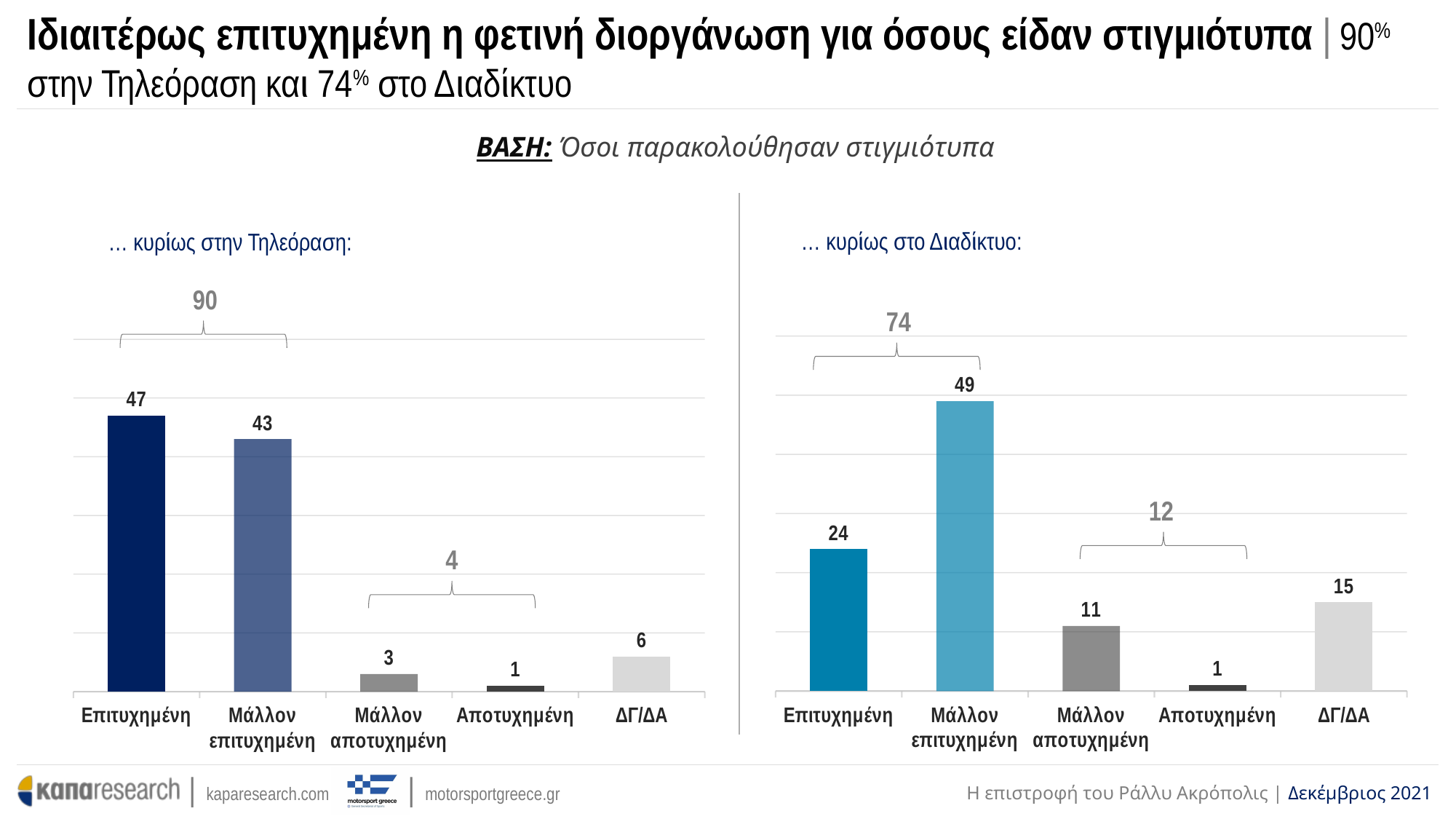
In the left chart (... κυρίως στην Τηλεόραση), what is the value for Επιτυχημένη? 47 How many categories are shown in the left chart (... κυρίως στην Τηλεόραση)? 5 What type of chart is used on the slide? Bar chart In the left chart (... κυρίως στην Τηλεόραση), what combined value is shown by the bracket over Επιτυχημένη and Μάλλον επιτυχημένη? 90 In the right chart (... κυρίως στο Διαδίκτυο), what is the difference between Μάλλον επιτυχημένη and Επιτυχημένη? 25 In the left chart (... κυρίως στην Τηλεόραση), which category has the highest value? Επιτυχημένη In the right chart (... κυρίως στο Διαδίκτυο), what is the value for Μάλλον αποτυχημένη? 11 In the left chart (... κυρίως στην Τηλεόραση), what is the difference between Επιτυχημένη and Μάλλον επιτυχημένη? 4 In the right chart (... κυρίως στο Διαδίκτυο), what is the value for Μάλλον επιτυχημένη? 49 Which is larger: ΔΓ/ΔΑ in the left chart (Τηλεόραση) or ΔΓ/ΔΑ in the right chart (Διαδίκτυο)? ΔΓ/ΔΑ in the right chart (Διαδίκτυο) In the right chart (... κυρίως στο Διαδίκτυο), which category has the lowest value? Αποτυχημένη In the right chart (... κυρίως στο Διαδίκτυο), what combined value is shown by the bracket over Μάλλον αποτυχημένη and Αποτυχημένη? 12